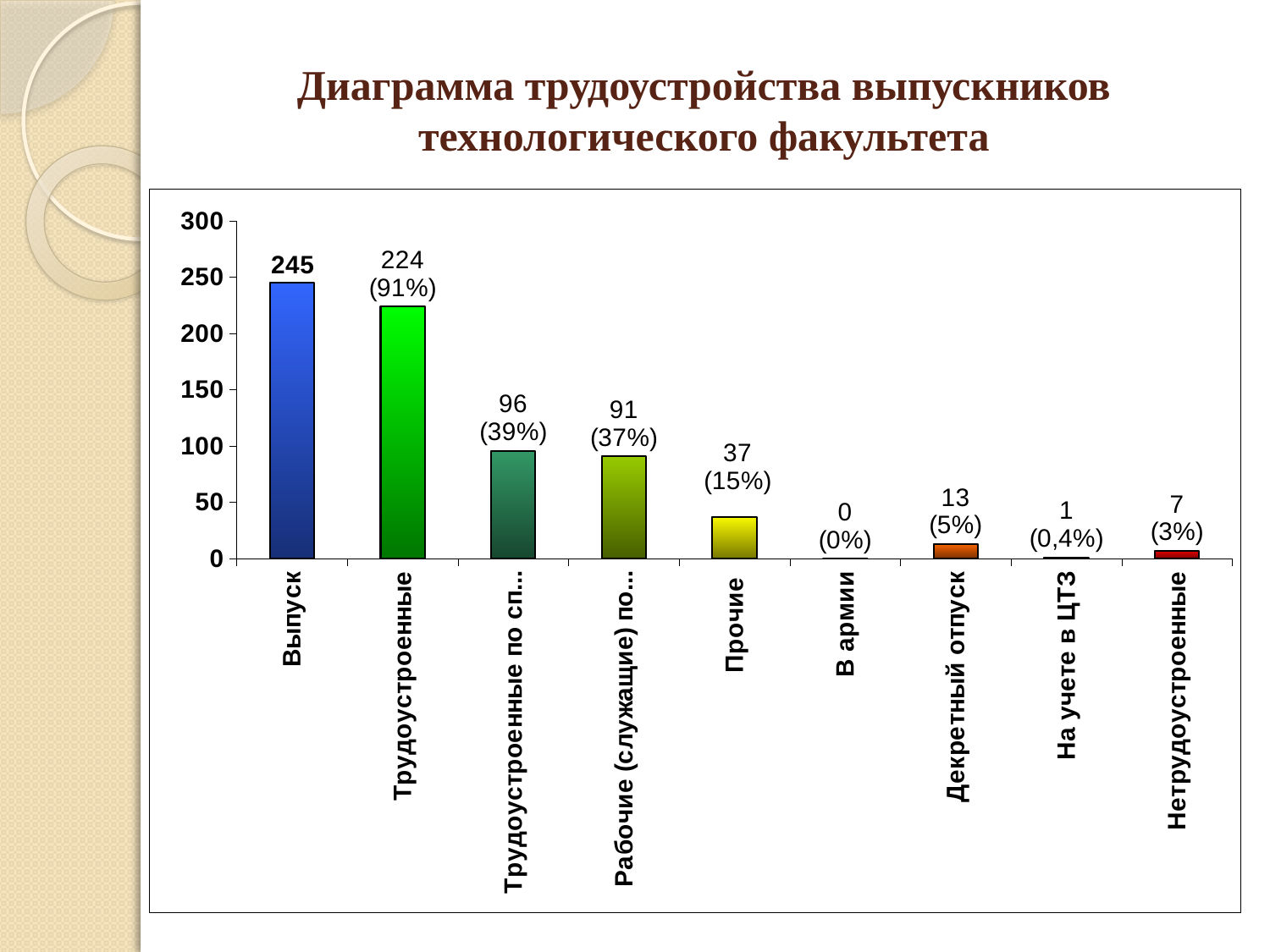
What is the difference between the values for Выпуск and Трудоустроенные? 21 What is the value for Декретный отпуск? 13 How many categories are shown on the x axis? 9 What is the value for Трудоустроенные? 224 What percentage is shown for Прочие? 15% Which is larger, the value for Нетрудоустроенные or the value for Декретный отпуск? Декретный отпуск What percentage is shown for На учете в ЦТЗ? 0,4% Which category has the highest value? Выпуск What is the value for Выпуск? 245 What is the title of the slide? Диаграмма трудоустройства выпускников технологического факультета Which category has the lowest value? В армии What kind of chart is shown on the slide? bar chart